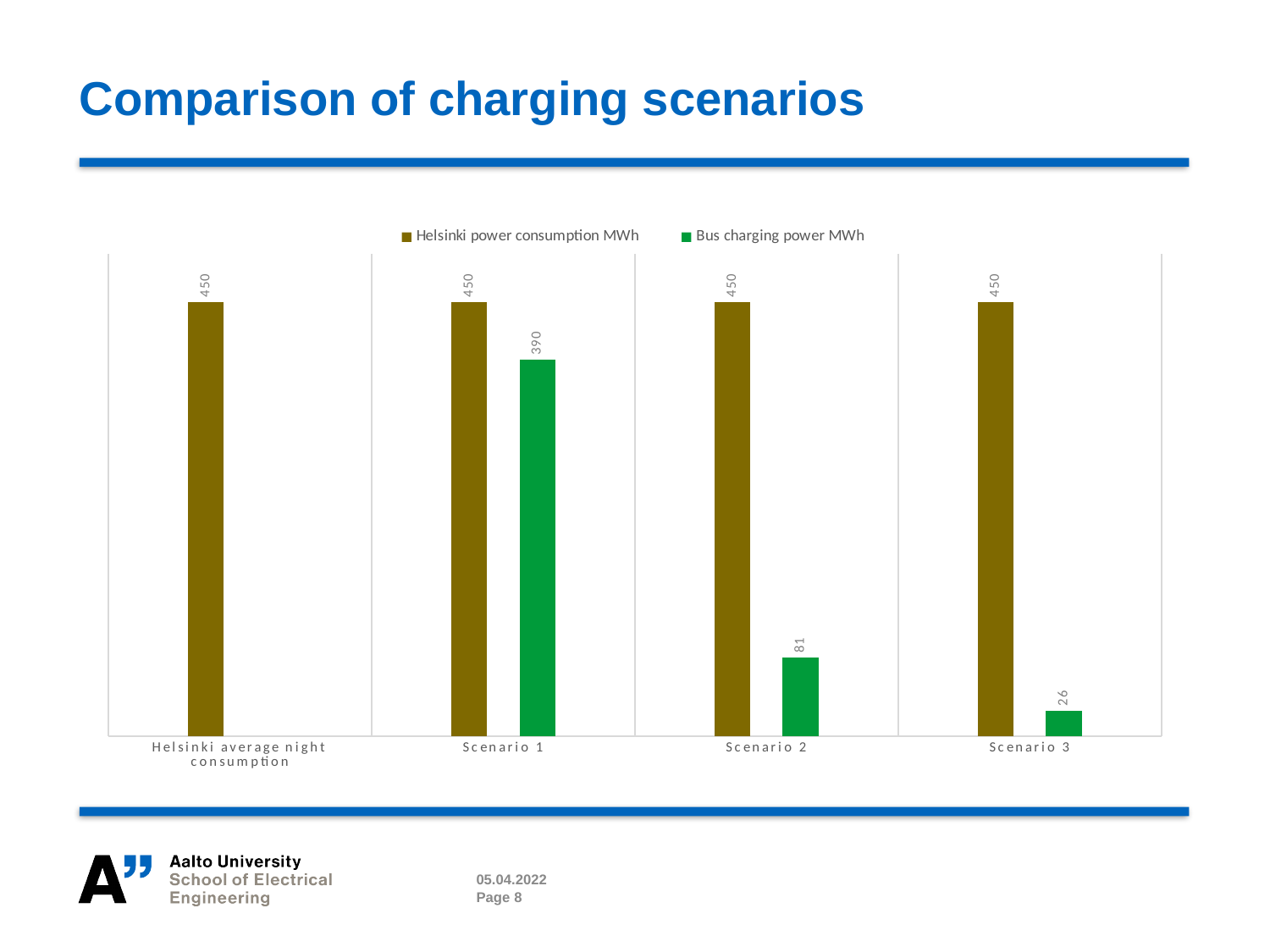
How many categories are shown on the x axis? 4 What is the Helsinki power consumption MWh value for Scenario 2? 450 Which scenario has the lowest Bus charging power MWh? Scenario 3 Which scenario has the highest Bus charging power MWh? Scenario 1 What kind of chart is shown on the slide? Bar chart Which is larger for Scenario 2: Helsinki power consumption MWh or Bus charging power MWh? Helsinki power consumption MWh What is the Bus charging power MWh value for Scenario 1? 390 What is the Bus charging power MWh value for Scenario 2? 81 How many series does the legend list? 2 What is the difference between Helsinki power consumption MWh and Bus charging power MWh for Scenario 3? 424 What is the difference between the Bus charging power MWh values for Scenario 1 and Scenario 2? 309 What is the Bus charging power MWh value for Scenario 3? 26